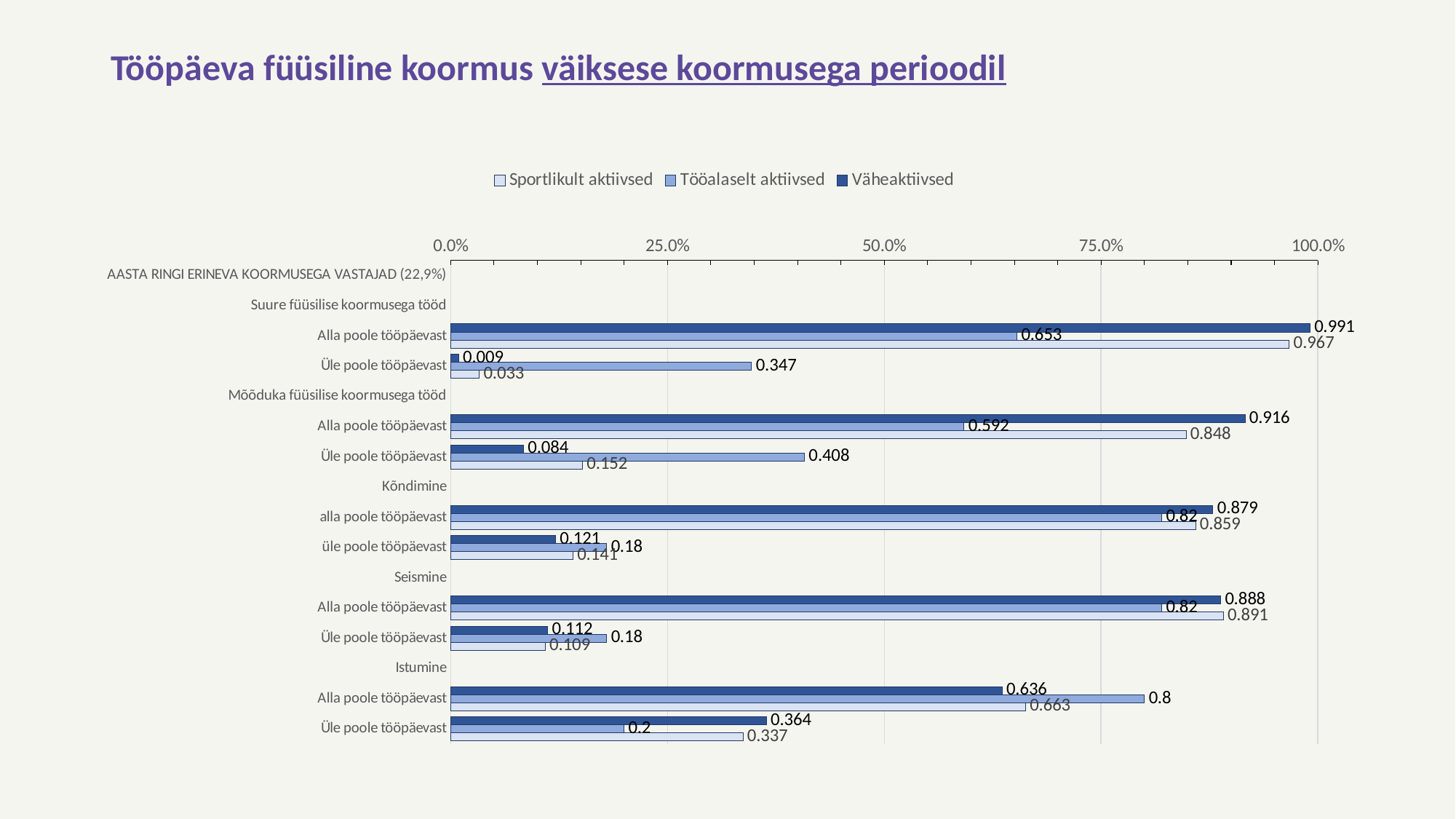
Under "Mõõduka füüsilise koormusega tööd", what is the value for Sportlikult aktiivsed for "Alla poole tööpäevast"? 0.848 Under "Mõõduka füüsilise koormusega tööd", what is the difference between the Väheaktiivsed and Tööalaselt aktiivsed values for "Alla poole tööpäevast"? 0.324 Under "Istumine", which series has the highest value for "Üle poole tööpäevast"? Väheaktiivsed How many series does the legend list? 3 Under "Suure füüsilise koormusega tööd", what is the value for Tööalaselt aktiivsed for "Üle poole tööpäevast"? 0.347 Which series is drawn in the darkest blue? Väheaktiivsed Under "Seismine", is the Tööalaselt aktiivsed value for "Alla poole tööpäevast" greater or less than 75.0%? greater What kind of chart is shown on the slide? bar chart Under "Istumine", what is the value for Tööalaselt aktiivsed for "Alla poole tööpäevast"? 0.8 Under "Kõndimine", which is larger for "üle poole tööpäevast": Tööalaselt aktiivsed or Sportlikult aktiivsed? Tööalaselt aktiivsed Under "Suure füüsilise koormusega tööd", what is the value for Väheaktiivsed for "Alla poole tööpäevast"? 0.991 Under "Suure füüsilise koormusega tööd", which series has the lowest value for "Üle poole tööpäevast"? Väheaktiivsed